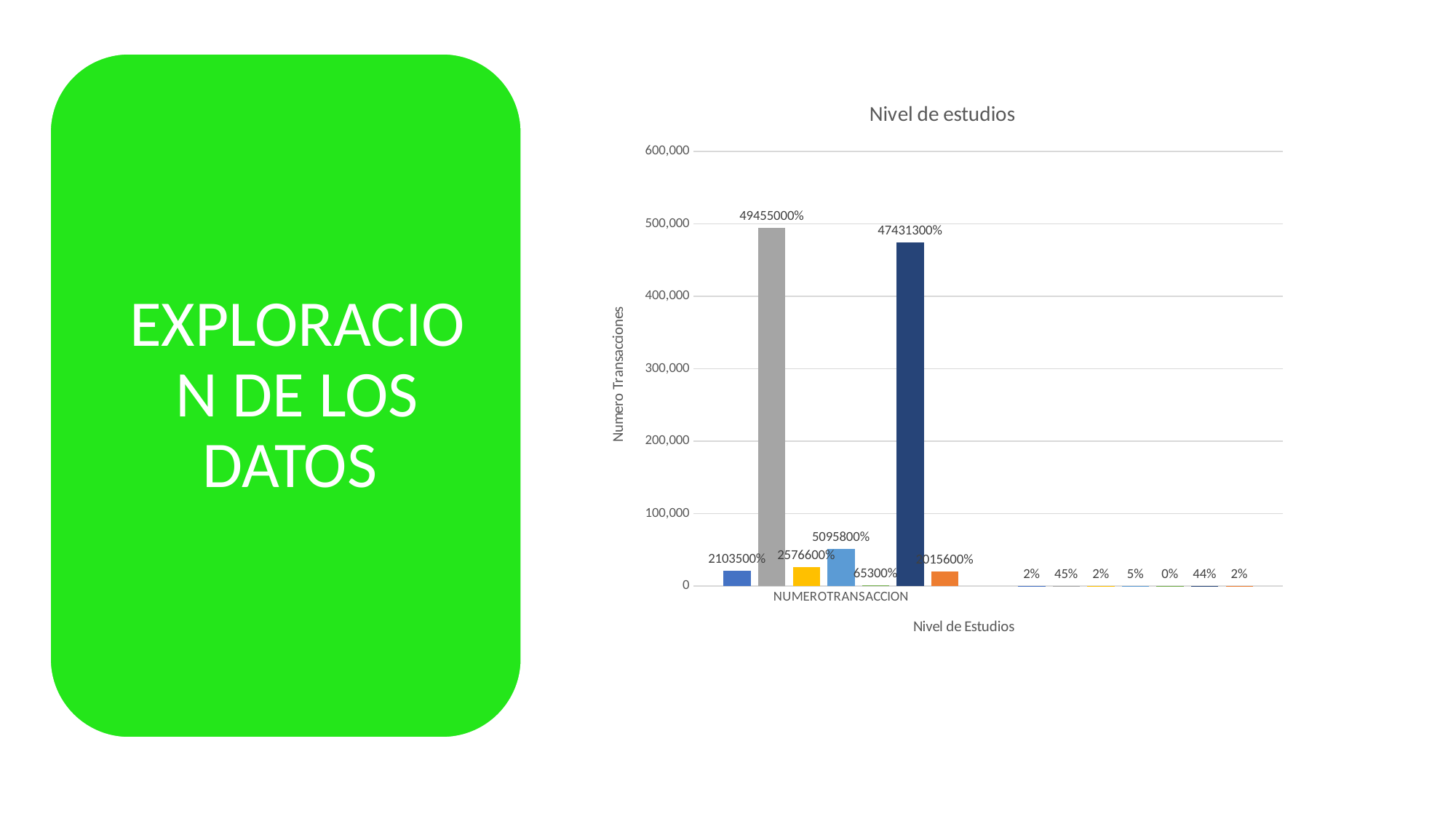
What is the difference between the gray bar label (49455000%) and the dark blue bar label (47431300%)? 2023700% Is the dark blue bar in the NUMEROTRANSACCION group greater or less than 400,000 on the y axis? greater How many bars are in the NUMEROTRANSACCION group? 7 What type of chart is shown on the slide? bar chart What is the data label on the light blue bar in the NUMEROTRANSACCION group? 5095800% What is the y-axis title of the chart? Numero Transacciones What is the data label on the gray bar in the NUMEROTRANSACCION group? 49455000% Which bar is the shortest in the NUMEROTRANSACCION group? the green bar (65300%) Which bar is the tallest in the NUMEROTRANSACCION group? the gray bar (49455000%) What is the title of the chart? Nivel de estudios What is the data label on the dark blue bar in the NUMEROTRANSACCION group? 47431300% What is the data label on the green bar in the NUMEROTRANSACCION group? 65300%